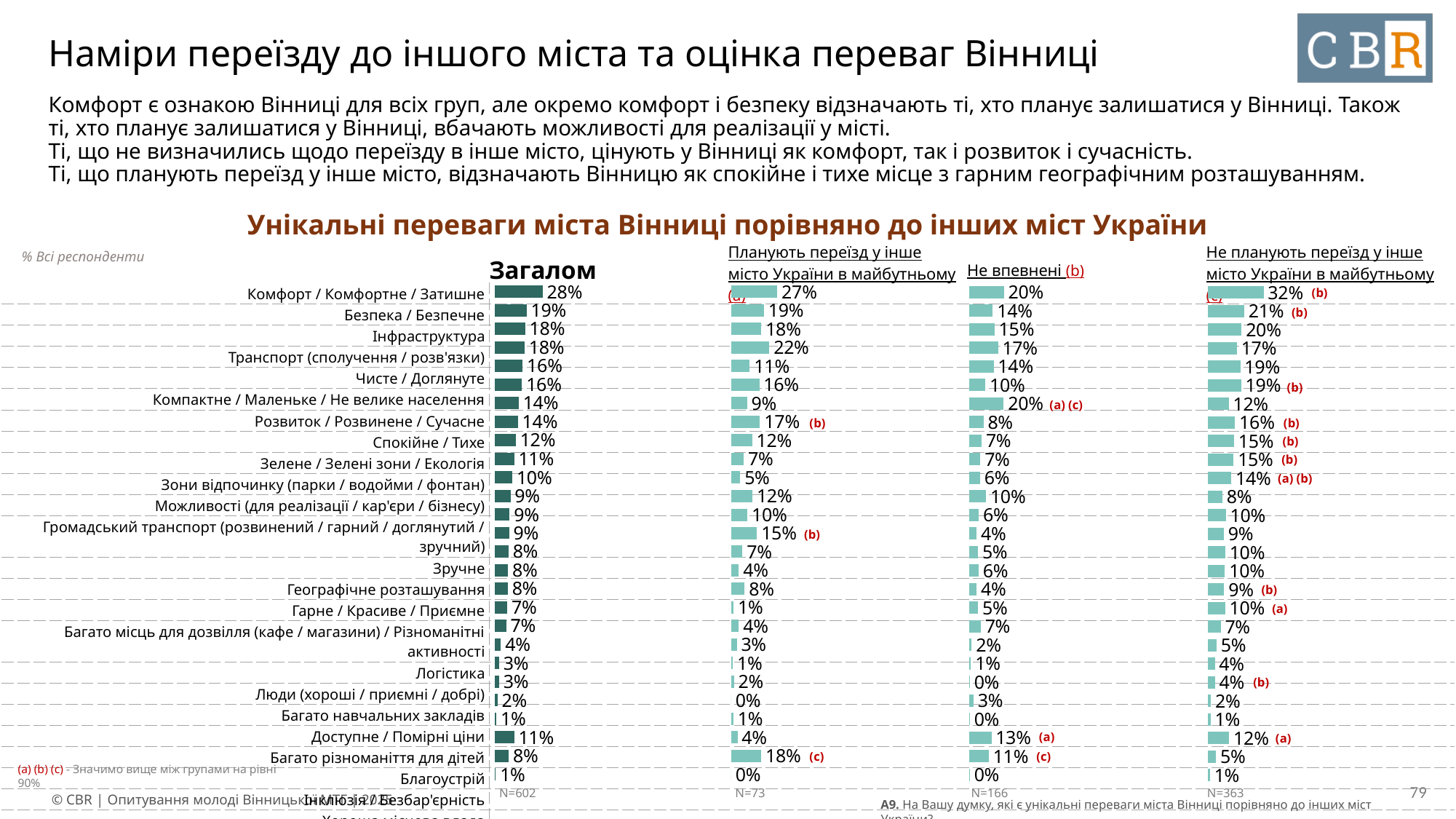
In the 'Не планують переїзд у інше місто України в майбутньому' chart, what is the value for 'Комфорт / Комфортне / Затишне'? 32% What is the sample size (N) shown under the 'Не впевнені' chart? N=166 In the 'Загалом' chart, what is the value for 'Комфорт / Комфортне / Затишне'? 28% In the 'Планують переїзд у інше місто України в майбутньому' chart, what is the value for 'Транспорт (сполучення / розв'язки)'? 22% Which is larger: the 'Безпека / Безпечне' value in the 'Загалом' chart or in the 'Не впевнені' chart? Загалом What is the title of the chart section on the slide? Унікальні переваги міста Вінниці порівняно до інших міст України How many bar charts are shown on the slide for the unique advantages of Vinnytsia? 4 In the 'Загалом' chart, which category has the highest value? Комфорт / Комфортне / Затишне In the 'Не впевнені' chart, what is the value for 'Комфорт / Комфортне / Затишне'? 20% What kind of chart is used on the slide to show the unique advantages of Vinnytsia? bar chart What is the difference between the 'Комфорт / Комфортне / Затишне' value in the 'Не планують переїзд' chart and in the 'Планують переїзд' chart? 5 percentage points In the 'Загалом' chart, what is the value for 'Безпека / Безпечне'? 19%